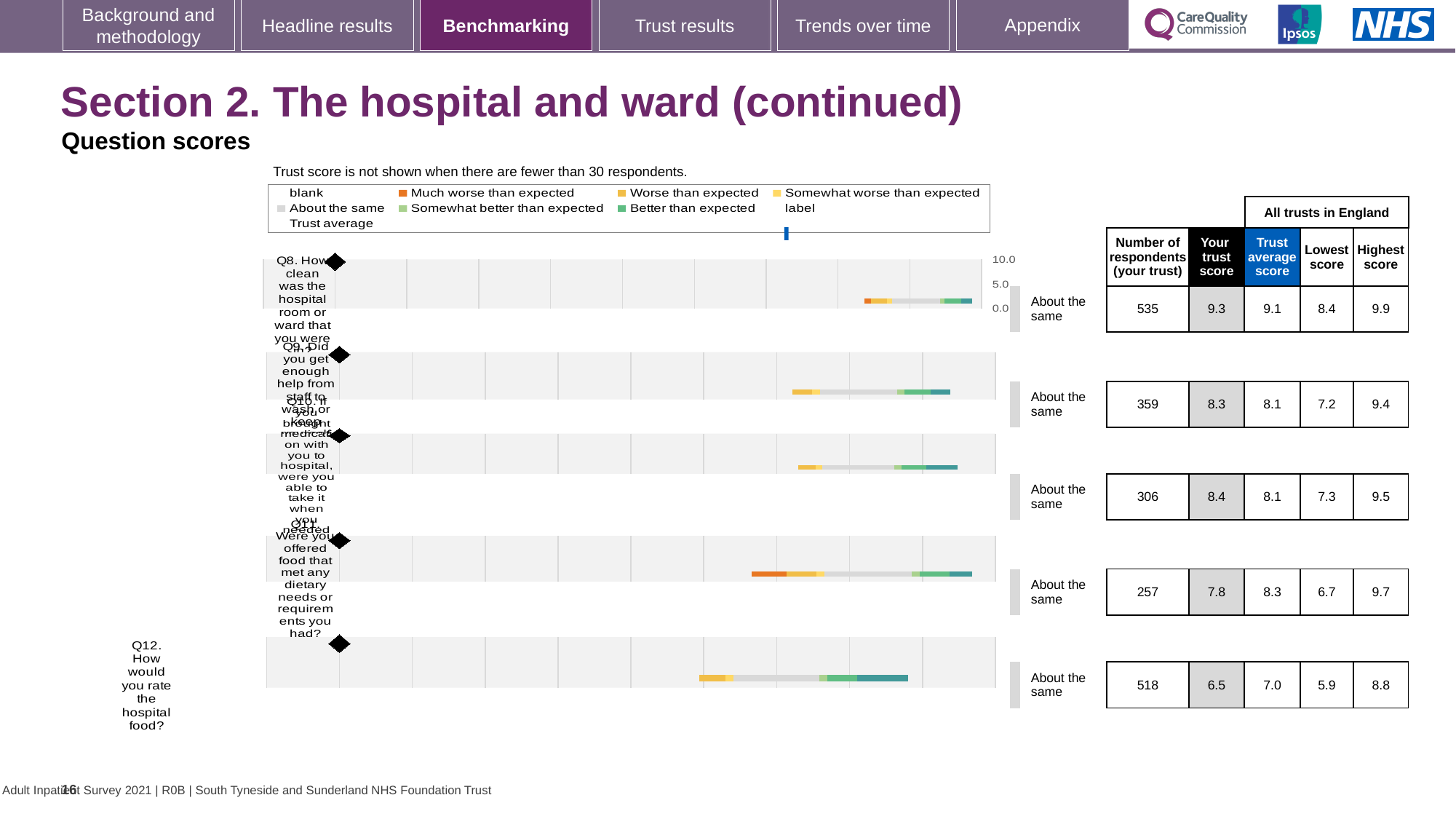
What is the trust average score for Q11, were you offered food that met any dietary needs or requirements you had? 8.3 How many respondents from your trust answered Q12, how would you rate the hospital food? 518 What is the difference between the highest score and the lowest score for Q12, how would you rate the hospital food? 2.9 What kind of chart is used to show the question scores? Bar chart How many questions are shown on this slide? 5 Is your trust score for Q11 higher or lower than the trust average score for that question? Lower What benchmark category is shown next to every question on this slide? About the same Which question has the lowest 'Your trust score'? Q12 (6.5) What is the 'Your trust score' for Q8, how clean was the hospital room or ward? 9.3 What is the lowest score across all trusts in England for Q9, did you get enough help from staff to wash or keep yourself clean? 7.2 Which question had the most respondents from your trust? Q8 (535) Which question has the highest 'Your trust score'? Q8 (9.3)